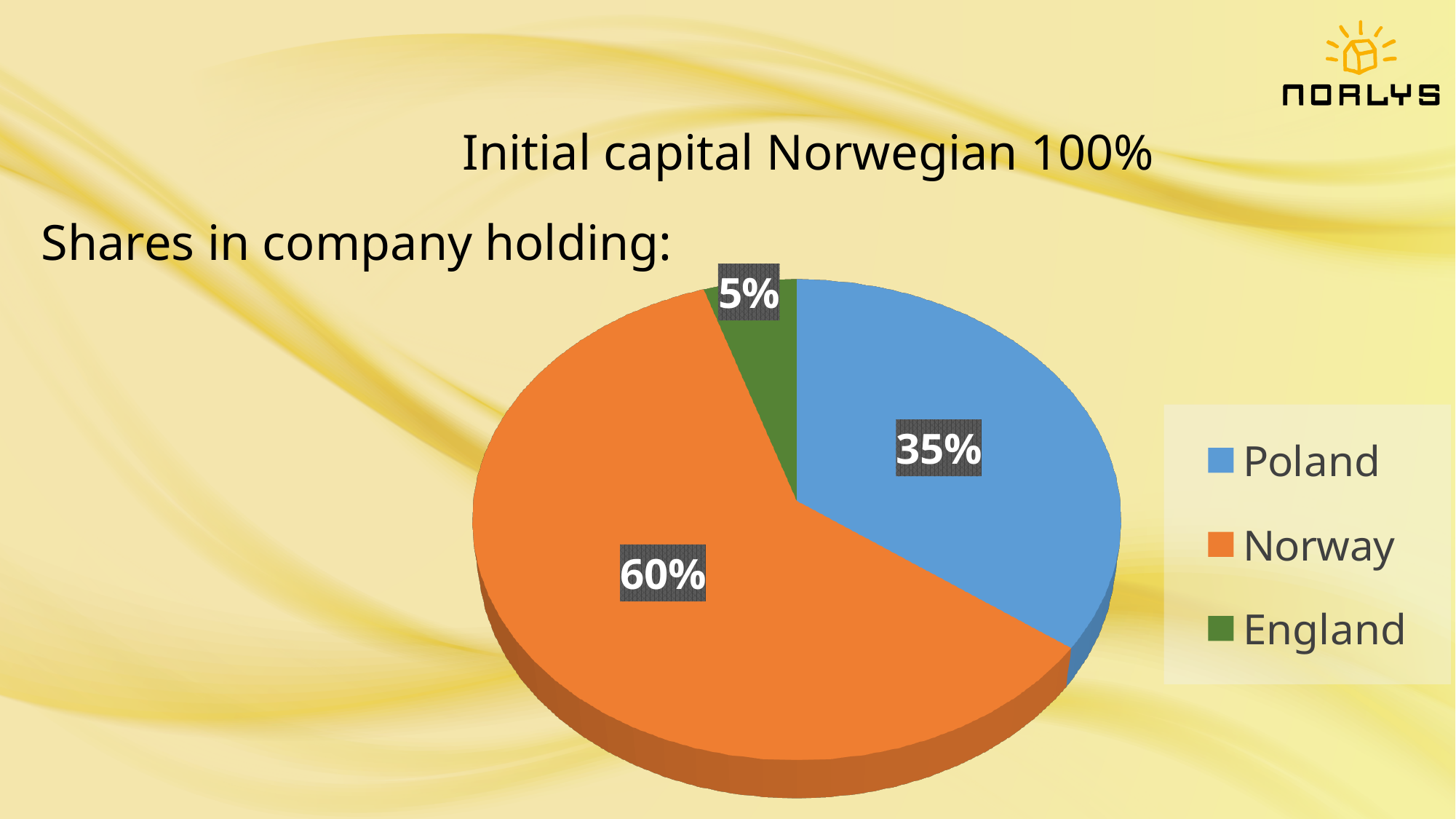
What is the difference in percentage points between Norway's share and Poland's share? 25 What share of the company holding does Poland have? 35% Which holds a larger share, Poland or England? Poland What share of the company holding does England have? 5% What is the difference in percentage points between Poland's share and England's share? 30 Which country holds the largest share in the company holding? Norway What kind of chart is shown on the slide? Pie chart Which country holds the smallest share in the company holding? England How many countries are shown in the pie chart? 3 What share of the company holding does Norway have? 60% What is the combined share of Poland and England? 40% What colour represents Norway in the pie chart? Orange